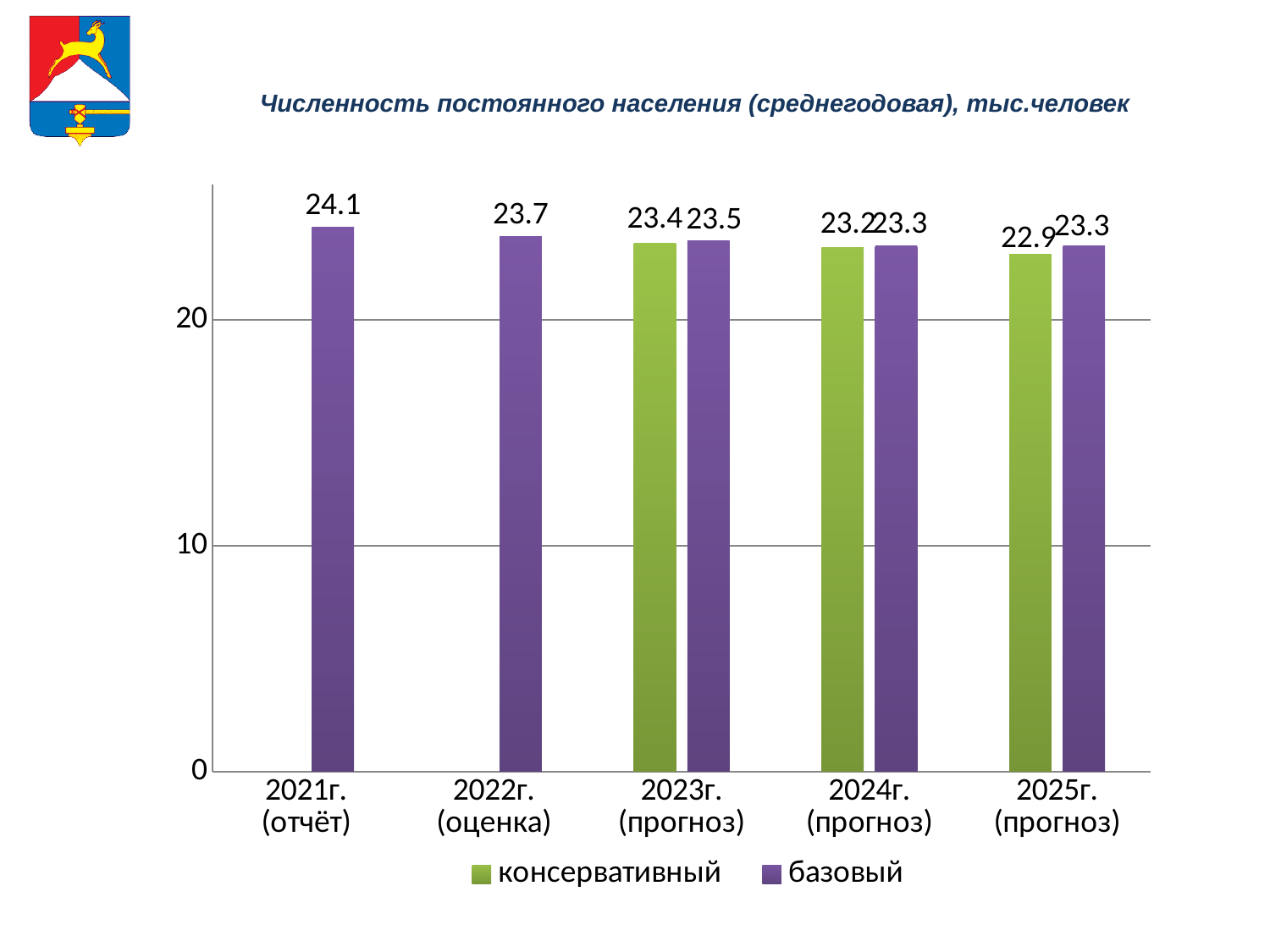
How many series does the legend list? 2 Is the консервативный value for 2023г. (прогноз) greater or less than 20? greater What kind of chart is shown on the slide? Bar chart Which year has the highest value for the базовый series? 2021г. (отчёт) What is the value of the консервативный series for 2024г. (прогноз)? 23.2 What is the value of the базовый series for 2023г. (прогноз)? 23.5 Which year has the lowest value for the консервативный series? 2025г. (прогноз) What is the value of the консервативный series for 2025г. (прогноз)? 22.9 What is the difference between the базовый values for 2021г. (отчёт) and 2022г. (оценка)? 0.4 What is the difference between the базовый and консервативный values for 2025г. (прогноз)? 0.4 Does the консервативный series rise or fall from 2023г. to 2025г.? Fall What is the value of the базовый series for 2021г. (отчёт)? 24.1